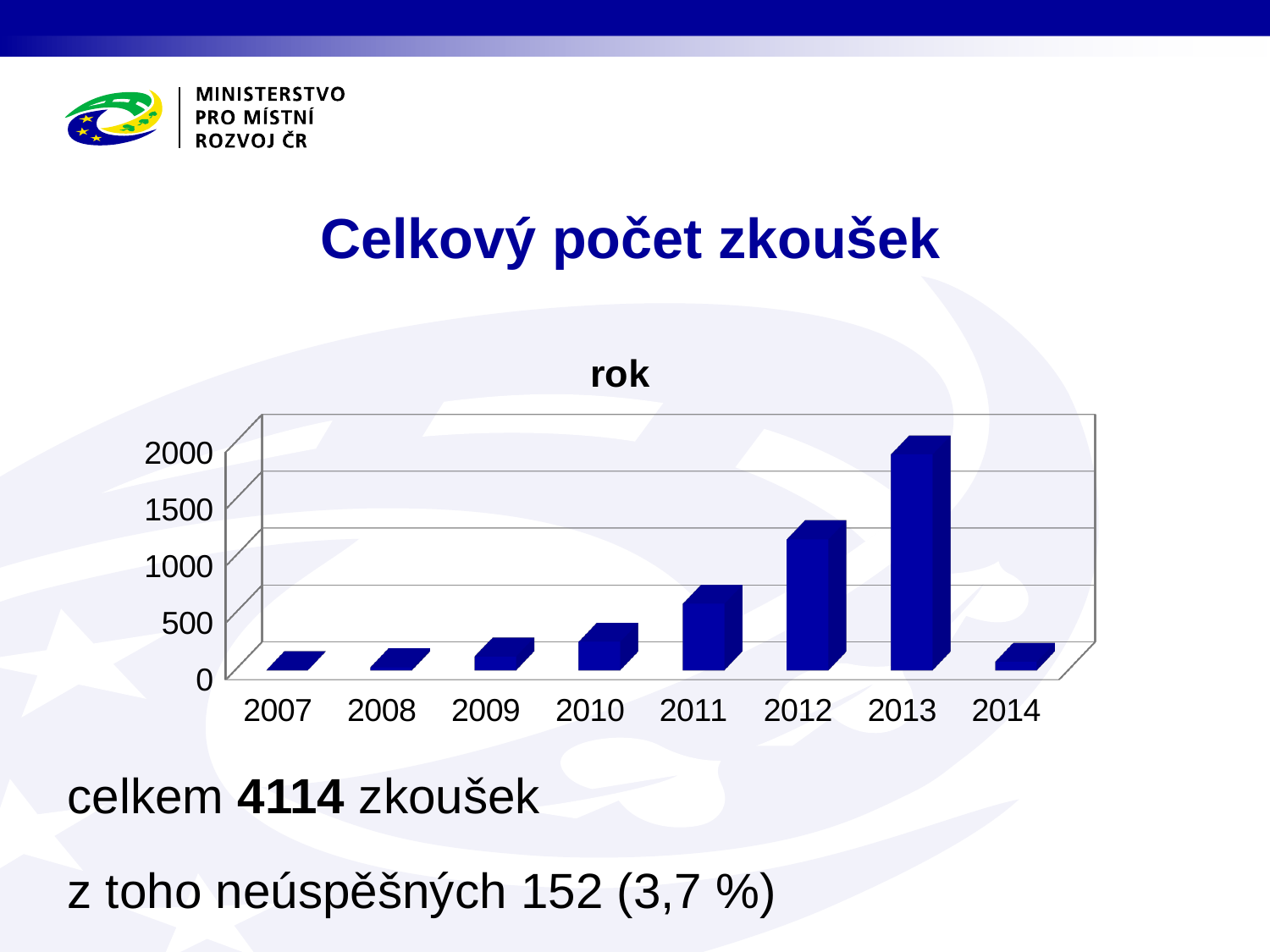
Is the value for 2010 greater or less than 500? less What kind of chart is shown on the slide? bar chart What is the title shown above the chart? rok Which year has the larger value, 2012 or 2013? 2013 Is the value for 2011 greater or less than 500? greater Is the value for 2012 greater or less than 1000? greater Which year has the highest number of exams in the chart? 2013 Which year has the larger value, 2011 or 2010? 2011 Do the values rise or fall from 2007 to 2013? rise How many years are shown on the x axis of the chart? 8